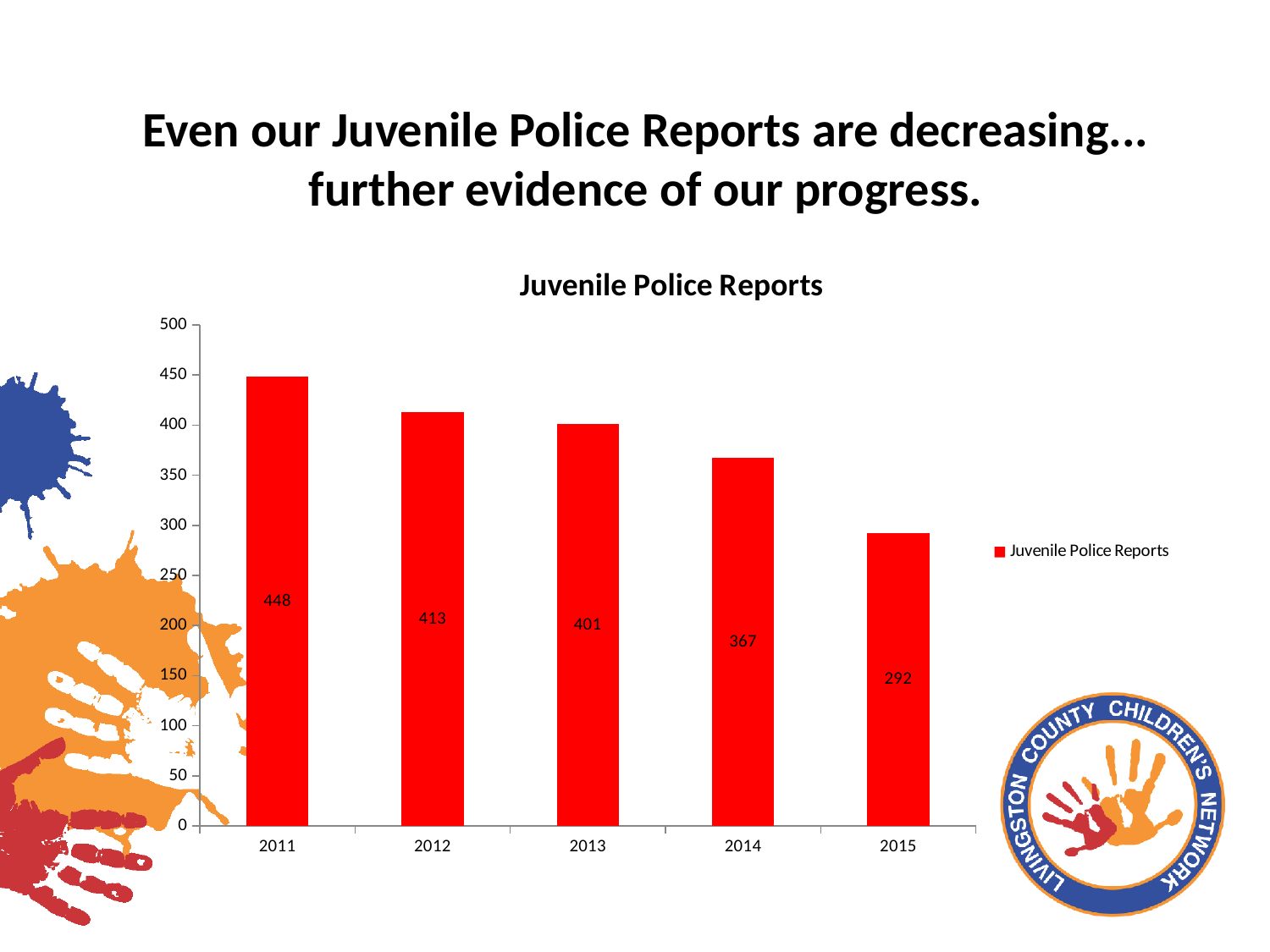
Which year has more Juvenile Police Reports, 2012 or 2014? 2012 What kind of chart is shown on the slide? bar chart Is the value for 2014 greater or less than 400? less Which year has the highest number of Juvenile Police Reports? 2011 Do the Juvenile Police Reports rise or fall from 2011 to 2015? fall What is the value of Juvenile Police Reports for 2013? 401 What is the difference between the Juvenile Police Reports in 2013 and 2014? 34 What is the value of Juvenile Police Reports for 2011? 448 What is the difference between the Juvenile Police Reports in 2011 and 2015? 156 What is the value of Juvenile Police Reports for 2015? 292 How many years are shown on the x axis of the chart? 5 Which year has the lowest number of Juvenile Police Reports? 2015